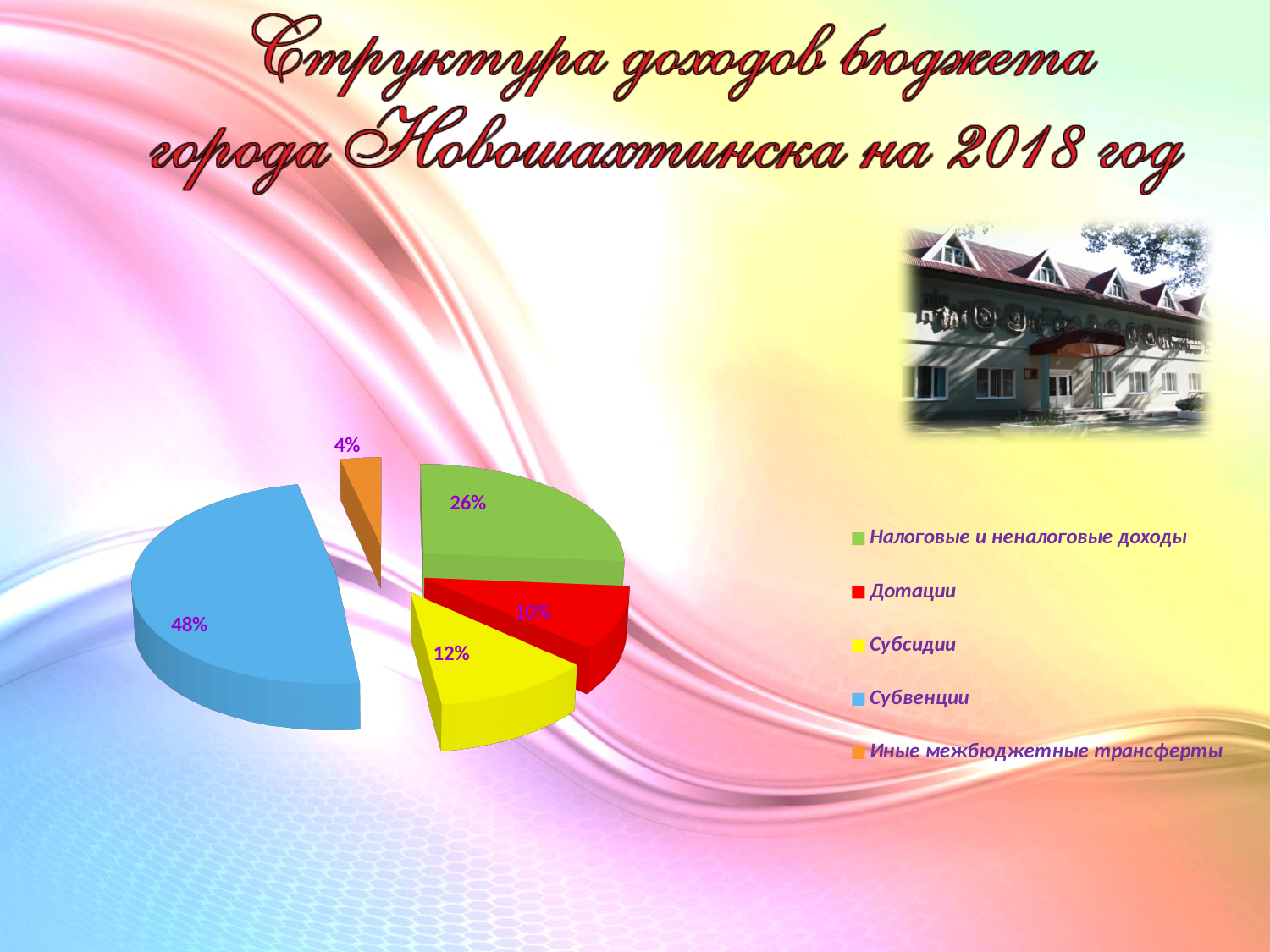
What is the difference in percentage points between Субвенции and Налоговые и неналоговые доходы? 22 What share of the pie does Субсидии have? 12% How many slices does the pie chart have? 5 Which is larger, the share for Субсидии or the share for Дотации? Субсидии What share of the pie does Субвенции have? 48% What share of the pie does Налоговые и неналоговые доходы have? 26% What kind of chart is shown on the slide? pie chart What colour is the slice for Субвенции? blue Which category has the smallest slice of the pie? Иные межбюджетные трансферты What share of the pie does Дотации have? 10% Which category has the largest slice of the pie? Субвенции What share of the pie does Иные межбюджетные трансферты have? 4%